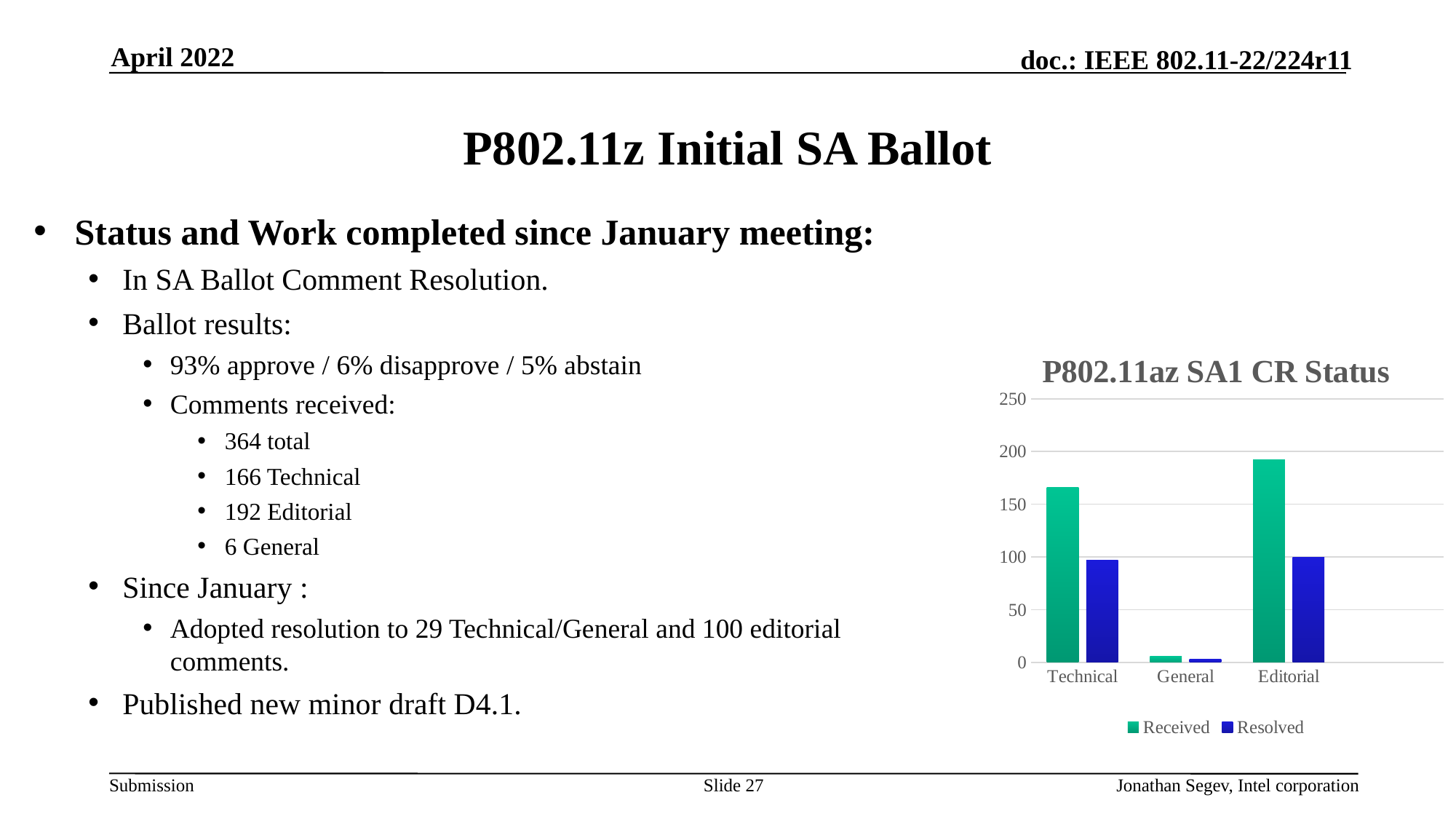
What is the title of the chart? P802.11az SA1 CR Status Which category has the highest Received value? Editorial Is the Resolved value for Technical greater or less than 50? greater Is the Received value for Technical greater or less than 150? greater How many categories are shown on the x axis of the chart? 3 For Technical, which is larger: the Received value or the Resolved value? Received Is the Received value for General greater or less than 50? less Which category has the lowest Received value? General What kind of chart is shown on the slide? bar chart Which category has the lowest Resolved value? General How many series does the chart legend list? 2